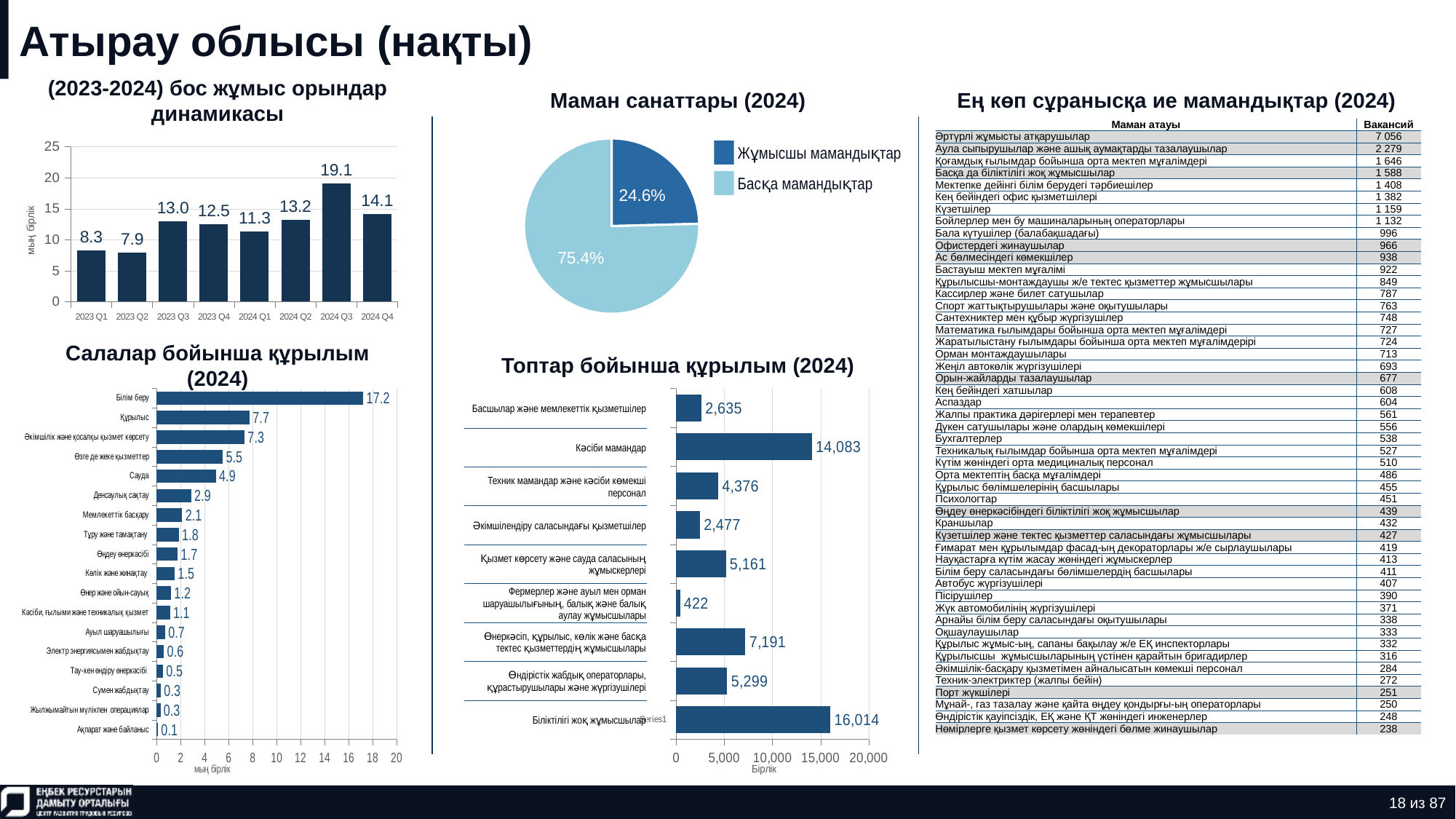
What kind of chart is 'Топтар бойынша құрылым (2024)'? Bar chart In the pie chart 'Маман санаттары (2024)', how many categories does the legend list? 2 In the chart 'Салалар бойынша құрылым (2024)', which is larger: 'Сауда' or 'Денсаулық сақтау'? Сауда In the chart '(2023-2024) бос жұмыс орындар динамикасы', what is the difference between 2024 Q3 and 2024 Q4? 5.0 In the chart 'Салалар бойынша құрылым (2024)', what is the value for 'Құрылыс'? 7.7 In the pie chart 'Маман санаттары (2024)', what share is 'Жұмысшы мамандықтар'? 24.6% In the chart 'Топтар бойынша құрылым (2024)', what is the value for 'Кәсіби мамандар'? 14,083 In the chart '(2023-2024) бос жұмыс орындар динамикасы', which quarter has the lowest value? 2023 Q2 In the chart '(2023-2024) бос жұмыс орындар динамикасы', what is the value for 2024 Q3? 19.1 In the chart '(2023-2024) бос жұмыс орындар динамикасы', how many quarters are plotted? 8 In the chart 'Салалар бойынша құрылым (2024)', which category has the highest value? Білім беру In the chart 'Топтар бойынша құрылым (2024)', which category has the lowest value? Фермерлер және ауыл мен орман шаруашылығының, балық және балық аулау жұмысшылары